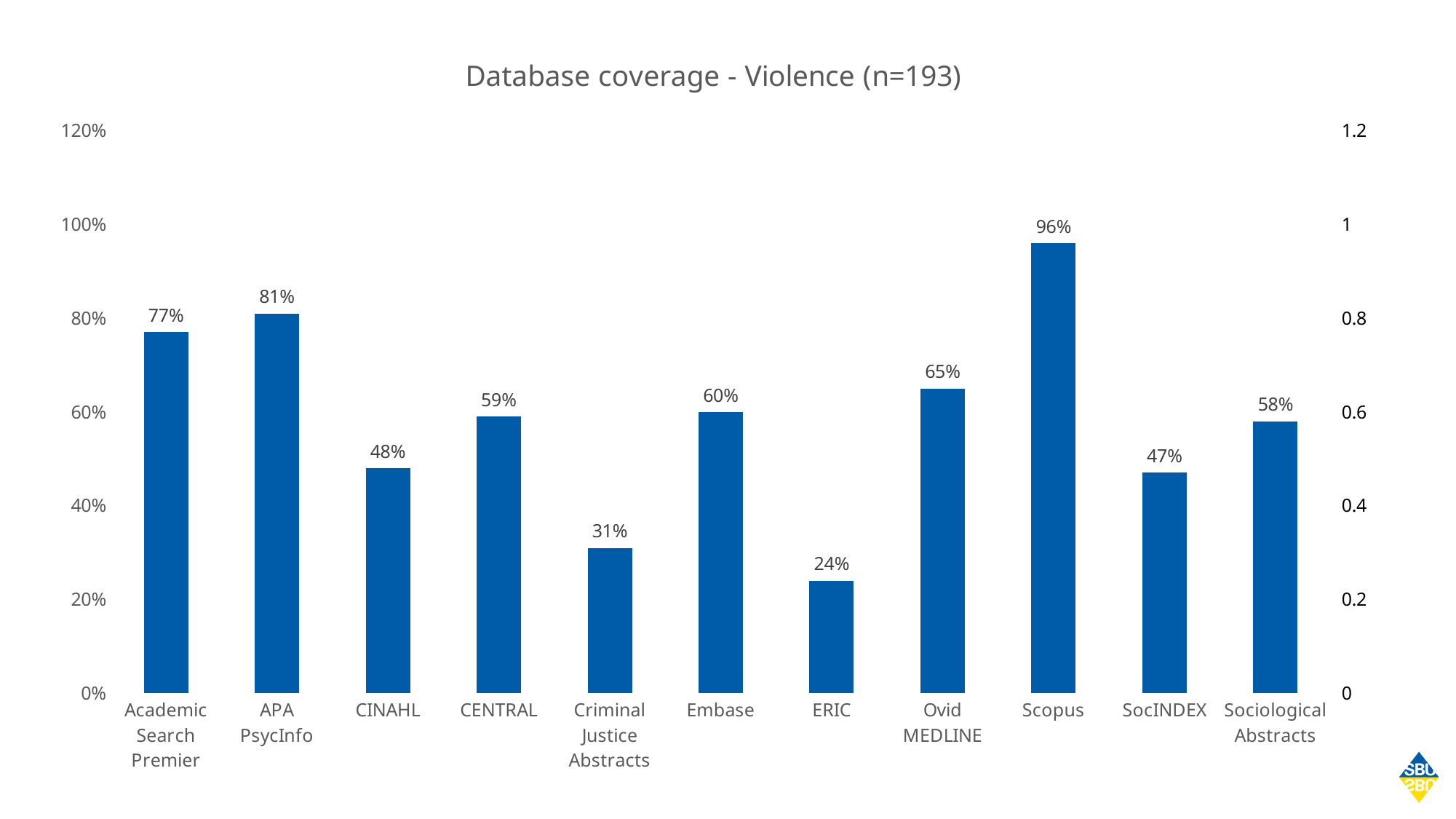
What is the database coverage value for Scopus? 96% What is the difference between the coverage of Scopus and ERIC? 72% Which database has the highest coverage? Scopus Which has higher coverage, CINAHL or CENTRAL? CENTRAL Which database has the lowest coverage? ERIC What is the difference between the coverage of APA PsycInfo and Academic Search Premier? 4% What is the database coverage value for Ovid MEDLINE? 65% What is the title of the chart? Database coverage - Violence (n=193) What is the database coverage value for ERIC? 24% Is the value for Criminal Justice Abstracts greater or less than 40%? less How many databases are shown on the chart? 11 What kind of chart is shown on the slide? Bar chart